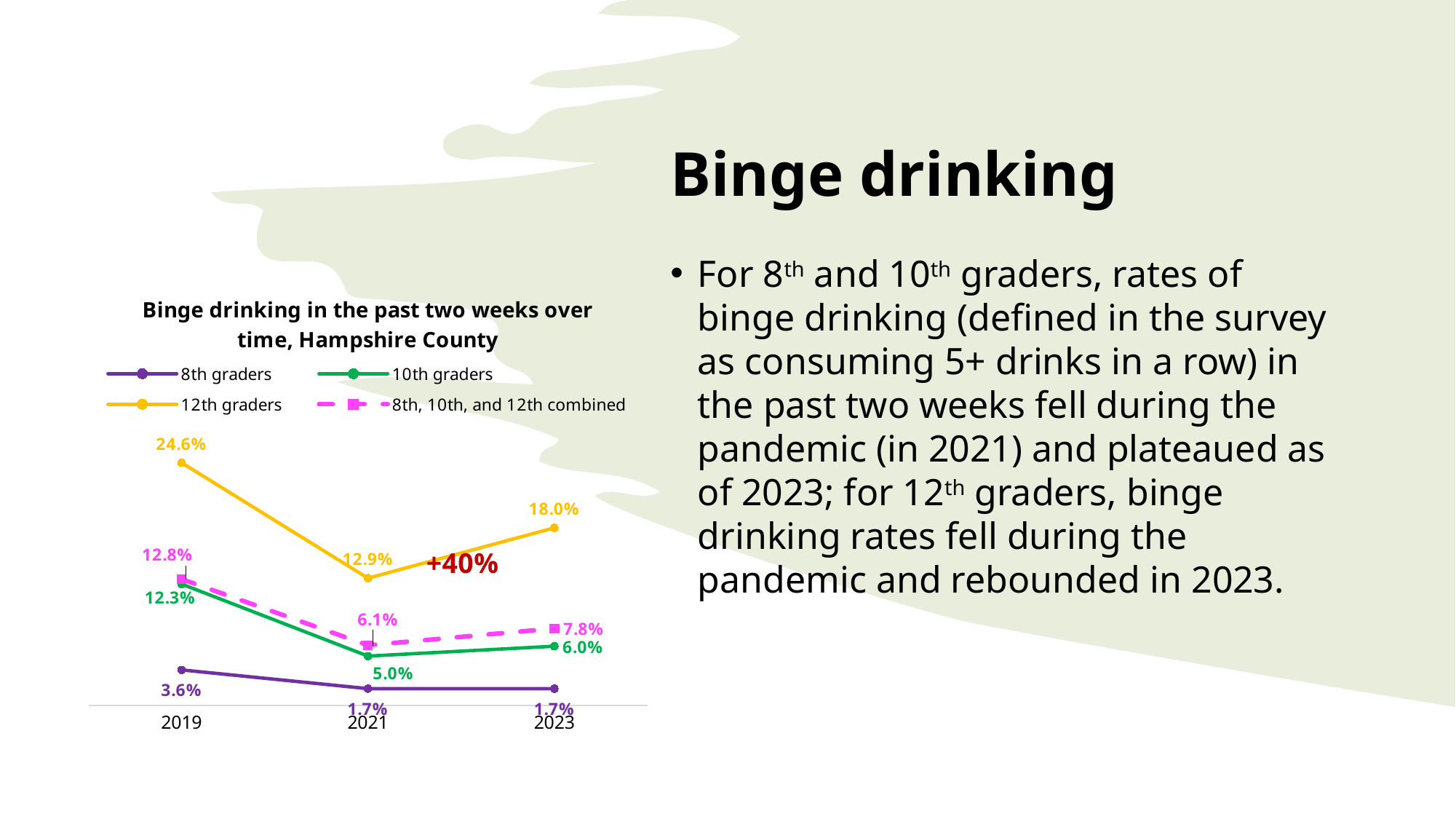
Which grade had the lowest binge drinking rate in 2023? 8th graders Which was higher in 2023: the 10th graders' rate or the combined rate? the combined rate What was the combined rate for 8th, 10th, and 12th graders in 2023? 7.8% What was the binge drinking rate for 12th graders in 2019? 24.6% What kind of chart is shown on the slide? line chart What is the difference between the 12th graders' rate in 2019 and in 2021? 11.7% What percentage change is annotated in red on the chart? +40% What was the binge drinking rate for 8th graders in 2019? 3.6% How many years are shown on the x axis? 3 Which year had the highest binge drinking rate for 12th graders? 2019 How many series does the legend list? 4 What was the binge drinking rate for 10th graders in 2021? 5.0%